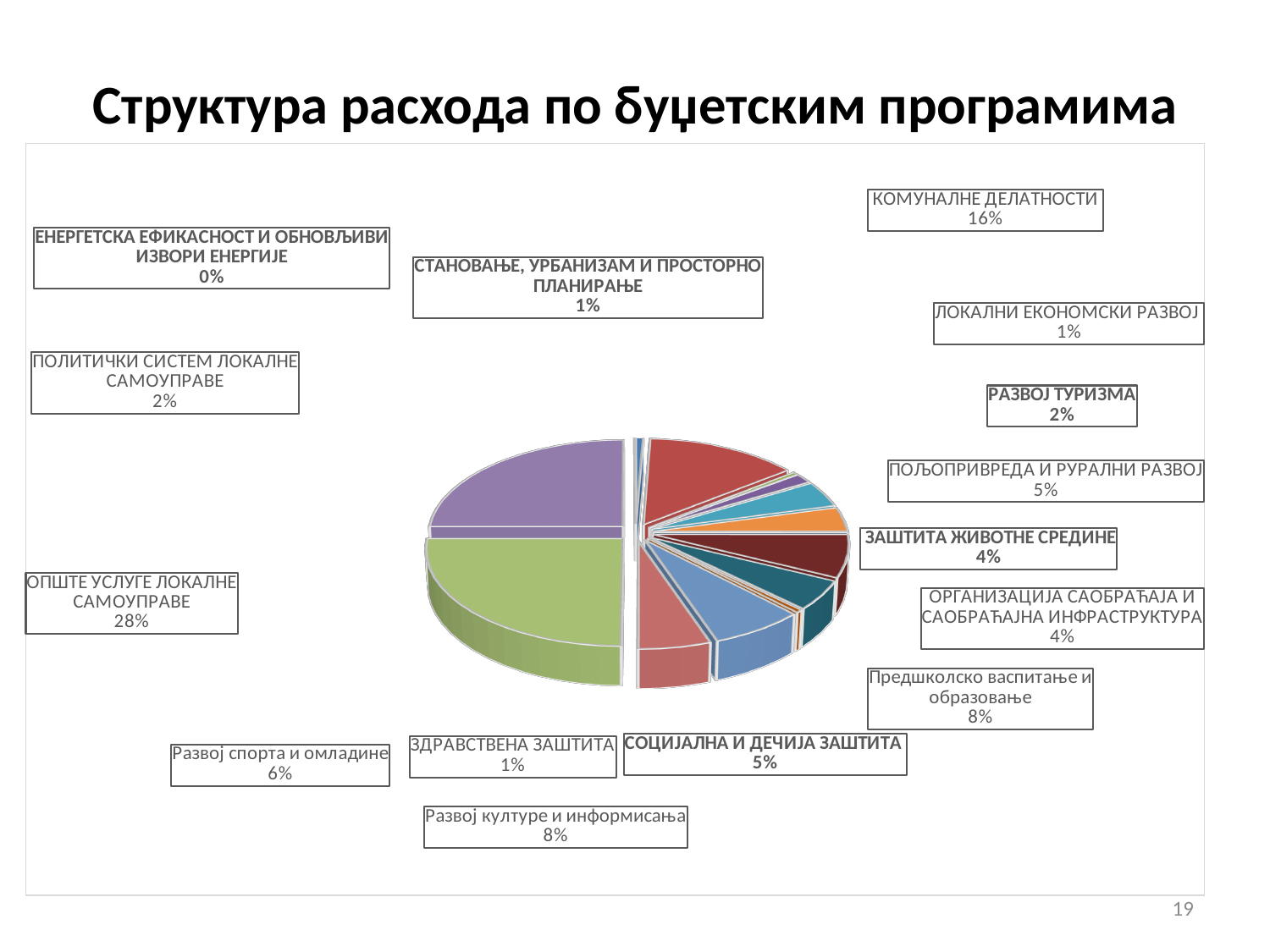
What is the difference in percentage points between ОПШТЕ УСЛУГЕ ЛОКАЛНЕ САМОУПРАВЕ and КОМУНАЛНЕ ДЕЛАТНОСТИ? 12 percentage points What share of expenditure goes to КОМУНАЛНЕ ДЕЛАТНОСТИ? 16% Which budget programme has the smallest share of expenditure? ЕНЕРГЕТСКА ЕФИКАСНОСТ И ОБНОВЉИВИ ИЗВОРИ ЕНЕРГИЈЕ What percentage is shown for Предшколско васпитање и образовање? 8% How many budget programmes are labelled in the pie chart? 15 What share of expenditure goes to СОЦИЈАЛНА И ДЕЧИЈА ЗАШТИТА? 5% What is the title of the chart on the slide? Структура расхода по буџетским програмима What share of expenditure goes to ОПШТЕ УСЛУГЕ ЛОКАЛНЕ САМОУПРАВЕ? 28% What percentage is shown for Развој спорта и омладине? 6% What type of chart is shown on the slide? Pie chart Which budget programme has the largest share of expenditure? ОПШТЕ УСЛУГЕ ЛОКАЛНЕ САМОУПРАВЕ Which has a larger share, ПОЉОПРИВРЕДА И РУРАЛНИ РАЗВОЈ or ЗАШТИТА ЖИВОТНЕ СРЕДИНЕ? ПОЉОПРИВРЕДА И РУРАЛНИ РАЗВОЈ